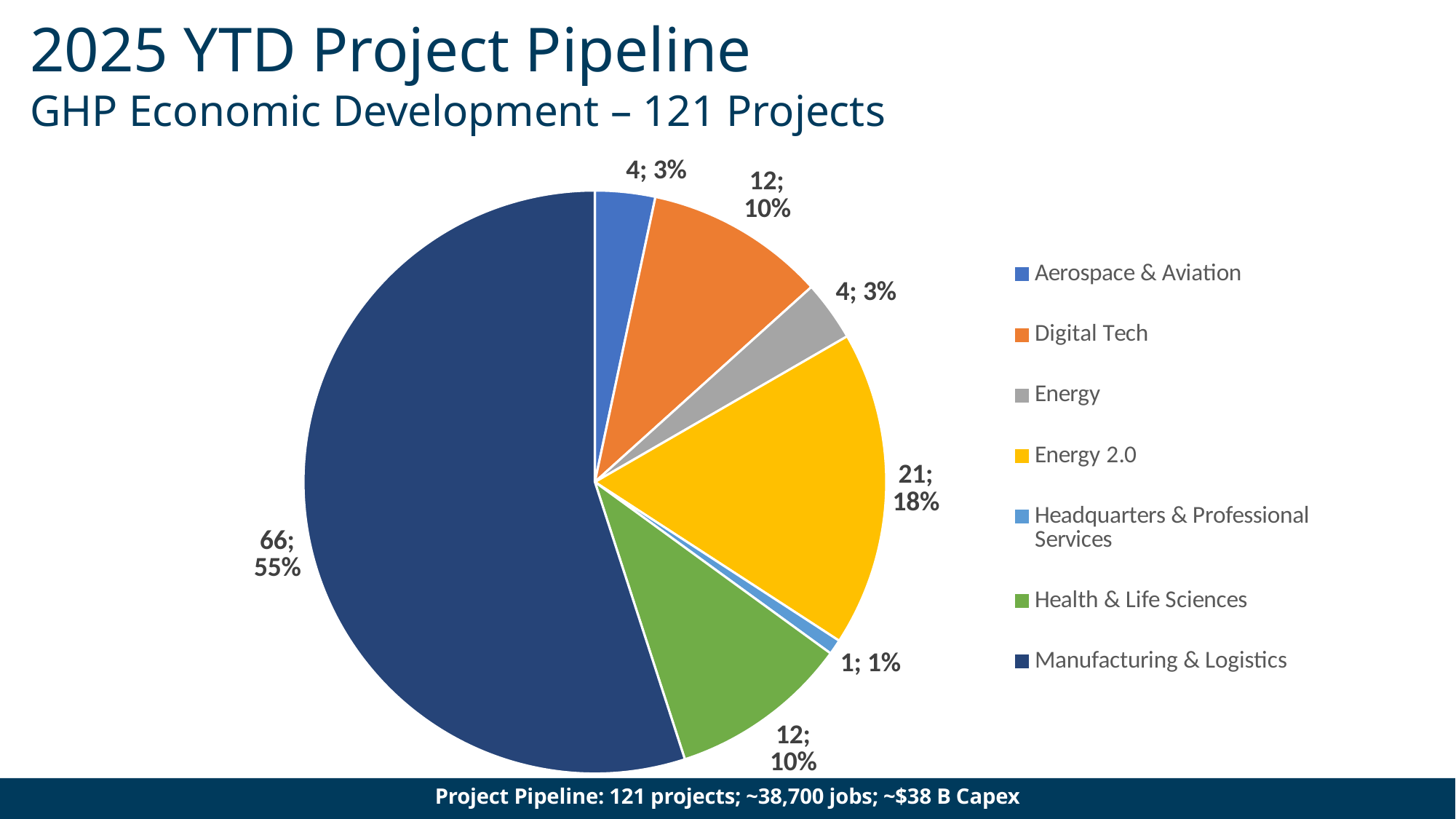
What share of the pie does Energy 2.0 represent? 18% What share of the pie does Manufacturing & Logistics represent? 55% How many categories does the legend list? 7 Which category has the largest slice of the pie? Manufacturing & Logistics How many projects are in the Manufacturing & Logistics slice? 66 How many projects are in the Digital Tech slice? 12 Which category has the smallest slice of the pie? Headquarters & Professional Services Which has more projects, Digital Tech or Aerospace & Aviation? Digital Tech What colour is the Energy 2.0 slice? Yellow What kind of chart is shown on the slide? Pie chart How many more projects does Energy 2.0 have than Energy? 17 What share of the pie does Health & Life Sciences represent? 10%